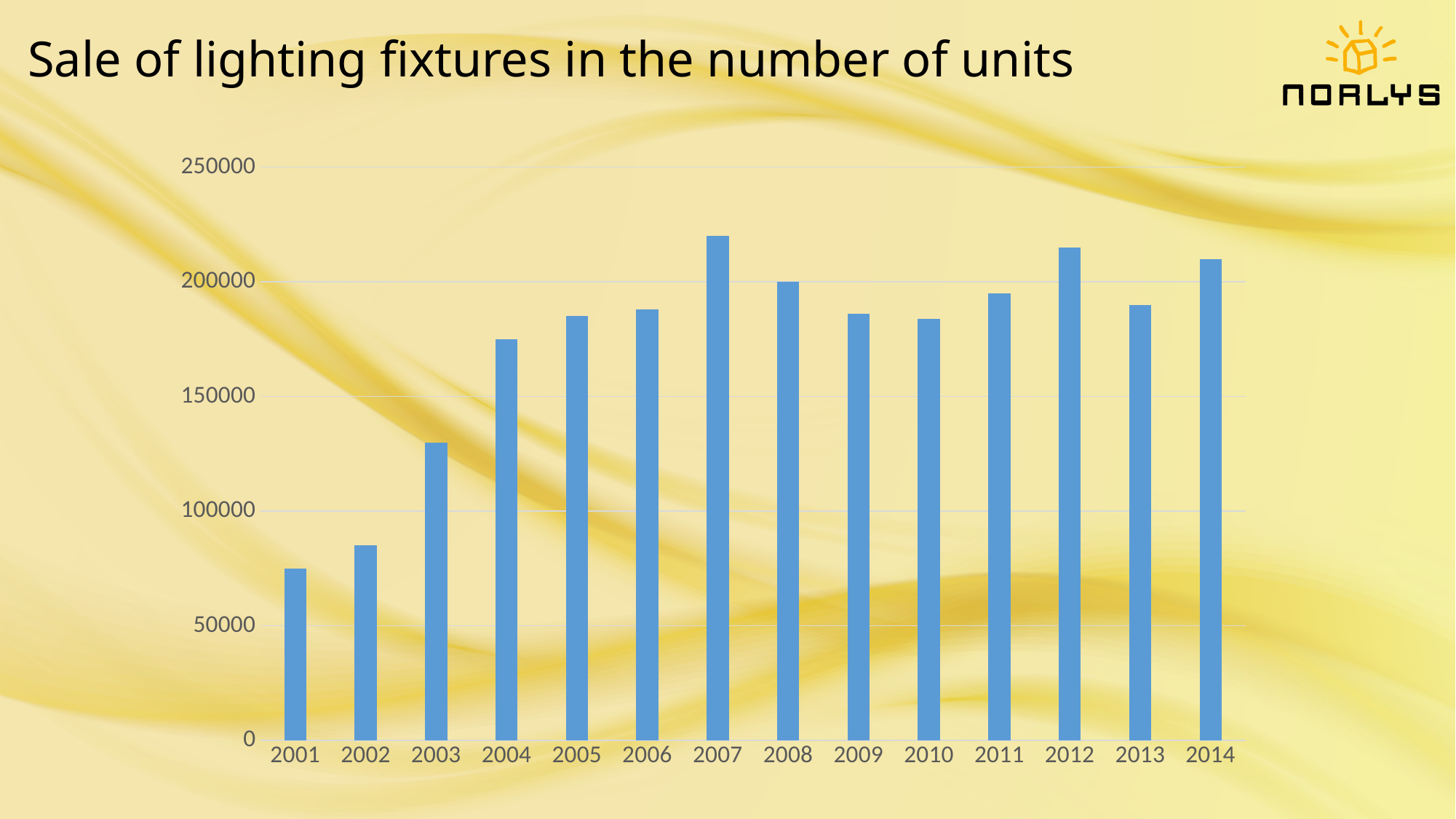
Is the value for 2004 greater or less than 150000? greater Which year has the larger value, 2003 or 2004? 2004 How many years are shown on the x axis of the chart? 14 Which year has the lowest number of units sold? 2001 What kind of chart is shown on the slide? bar chart Do the values rise or fall from 2001 to 2007? rise Which year has the highest number of units sold? 2007 Is the value for 2010 greater or less than 200000? less What is the title of the chart? Sale of lighting fixtures in the number of units Is the value for 2007 greater or less than 200000? greater